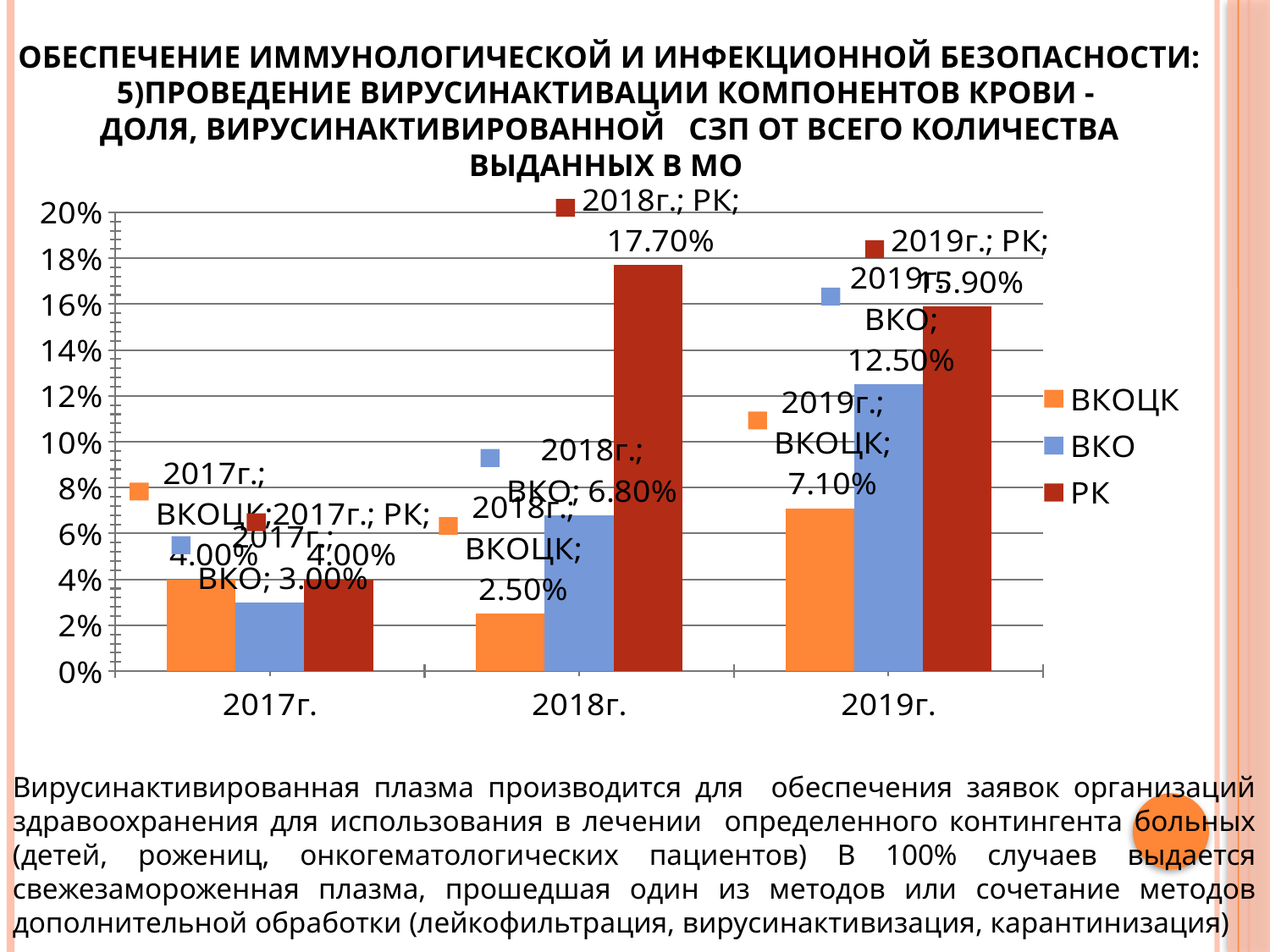
What is the difference between the РК value in 2018г. and the РК value in 2019г.? 1.80% Do the values for ВКО rise or fall from 2017г. to 2019г.? rise How many year categories are shown on the x axis? 3 What is the value for ВКО in 2019г.? 12.50% Which is larger in 2019г., the value for ВКО or the value for ВКОЦК? ВКО Which year has the highest value for РК? 2018г. Which year has the lowest value for ВКОЦК? 2018г. What is the value for ВКО in 2017г.? 3.00% What is the value for РК in 2018г.? 17.70% What kind of chart is shown on the slide? bar chart What is the value for ВКОЦК in 2018г.? 2.50% How many series does the legend list? 3